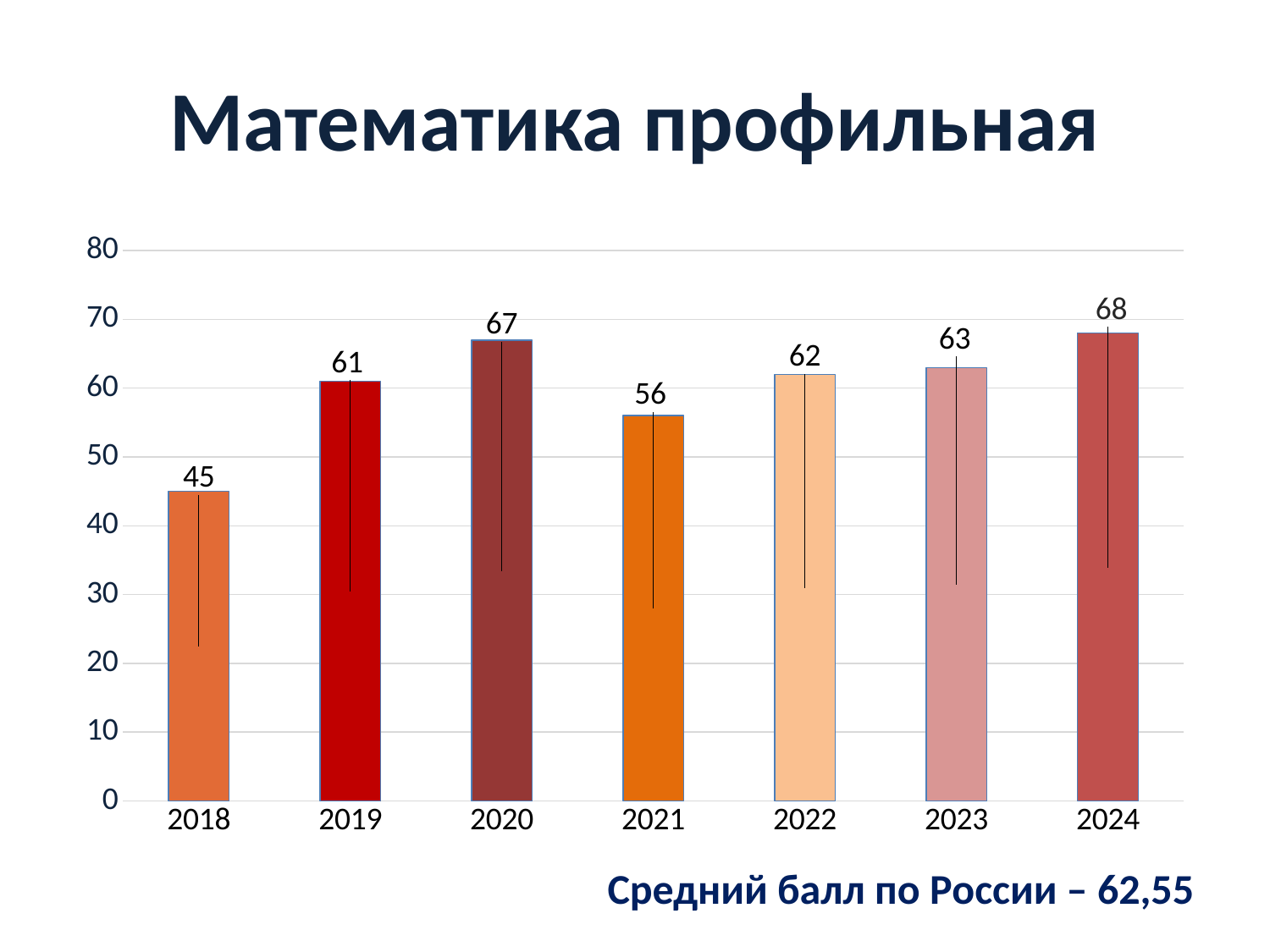
What is the difference between the values for 2020 and 2021? 11 Which is larger, the value for 2019 or the value for 2023? 2023 What is the value for 2018? 45 What kind of chart is shown on the slide? bar chart What is the difference between the values for 2024 and 2018? 23 Which year has the highest value? 2024 What is the title of the slide? Математика профильная What average score for Russia is stated below the chart? 62,55 What is the value for 2021? 56 Which year has the lowest value? 2018 What is the value for 2024? 68 How many years are shown on the x axis? 7